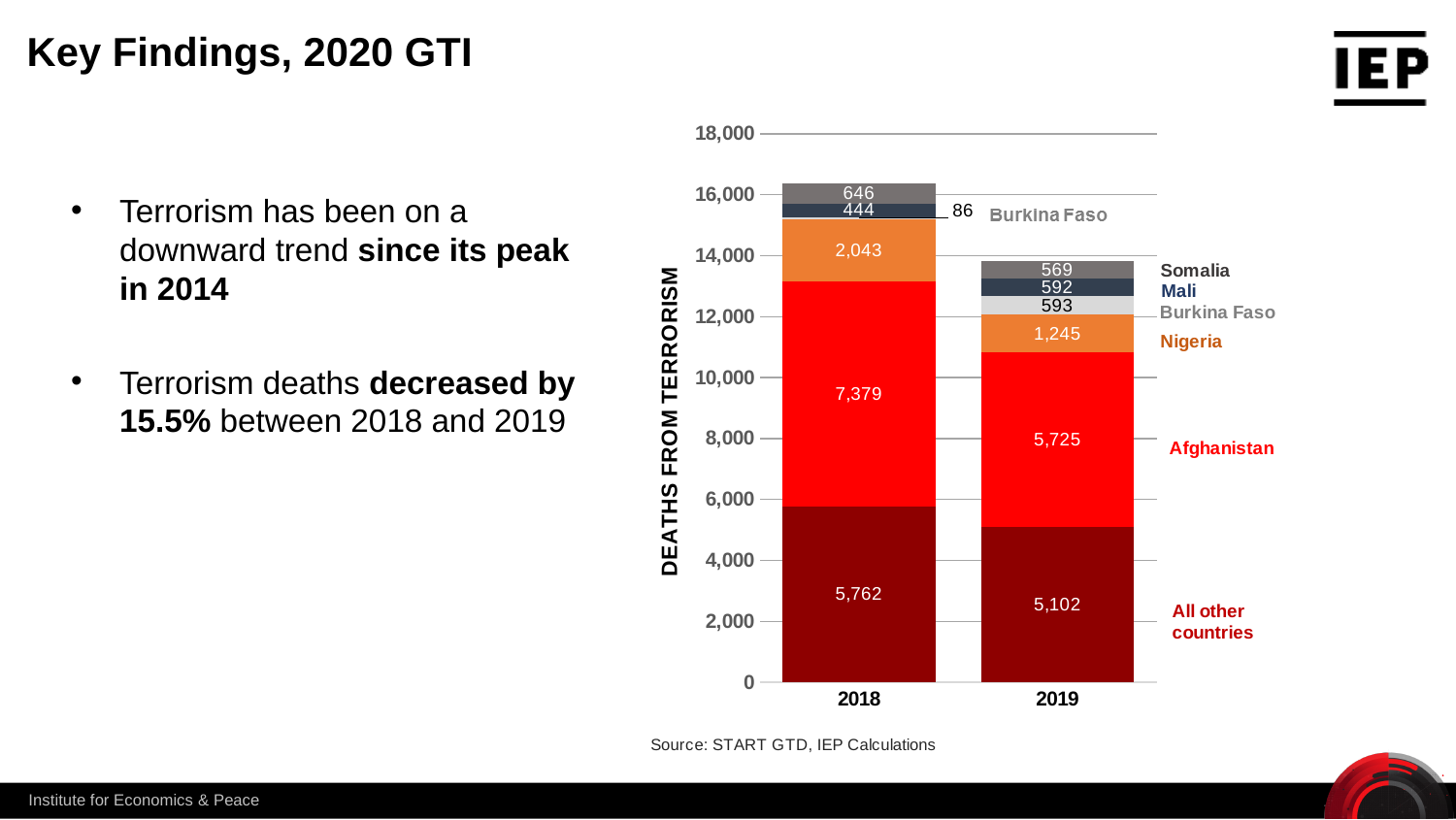
What is the value for Mali in 2019? 592 What is the value for Burkina Faso in 2018? 86 What is the value for 'All other countries' in 2019? 5,102 Which segment is the smallest in the 2018 bar? Burkina Faso What type of chart is shown on the slide? Stacked bar chart How many deaths from terrorism are attributed to Afghanistan in 2018? 7,379 Is the value for Nigeria larger in 2018 or 2019? 2018 How many countries or groups are listed in the chart's legend? 6 What is the value for Nigeria in 2019? 1,245 What is the total of the 2019 stacked bar? 13,826 Which segment is the largest in the 2018 bar? Afghanistan By how much did the Afghanistan value fall from 2018 to 2019? 1,654